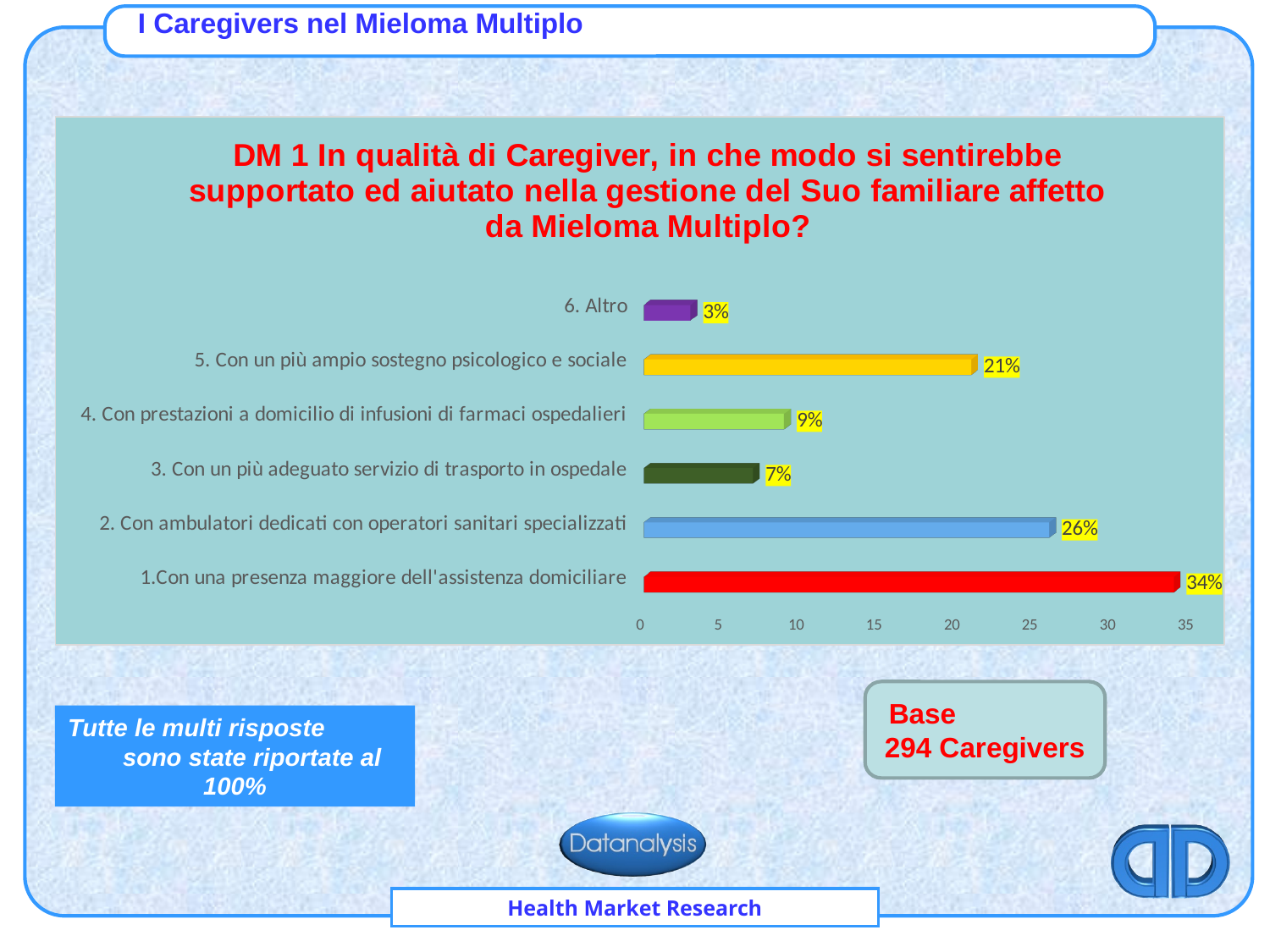
Is the value for "5. Con un più ampio sostegno psicologico e sociale" greater or less than 15? greater Which is larger: the value for "4. Con prestazioni a domicilio di infusioni di farmaci ospedalieri" or "3. Con un più adeguato servizio di trasporto in ospedale"? 4. Con prestazioni a domicilio di infusioni di farmaci ospedalieri What is the difference between the values for "1.Con una presenza maggiore dell'assistenza domiciliare" and "2. Con ambulatori dedicati con operatori sanitari specializzati"? 8% What kind of chart is shown on the slide? bar chart How many categories are shown in the chart? 6 Which category has the lowest value? 6. Altro What is the value for "1.Con una presenza maggiore dell'assistenza domiciliare"? 34% What is the maximum value shown on the horizontal axis? 35 What is the value for "6. Altro"? 3% Which category has the highest value? 1.Con una presenza maggiore dell'assistenza domiciliare What is the value for "2. Con ambulatori dedicati con operatori sanitari specializzati"? 26% What is the value for "5. Con un più ampio sostegno psicologico e sociale"? 21%